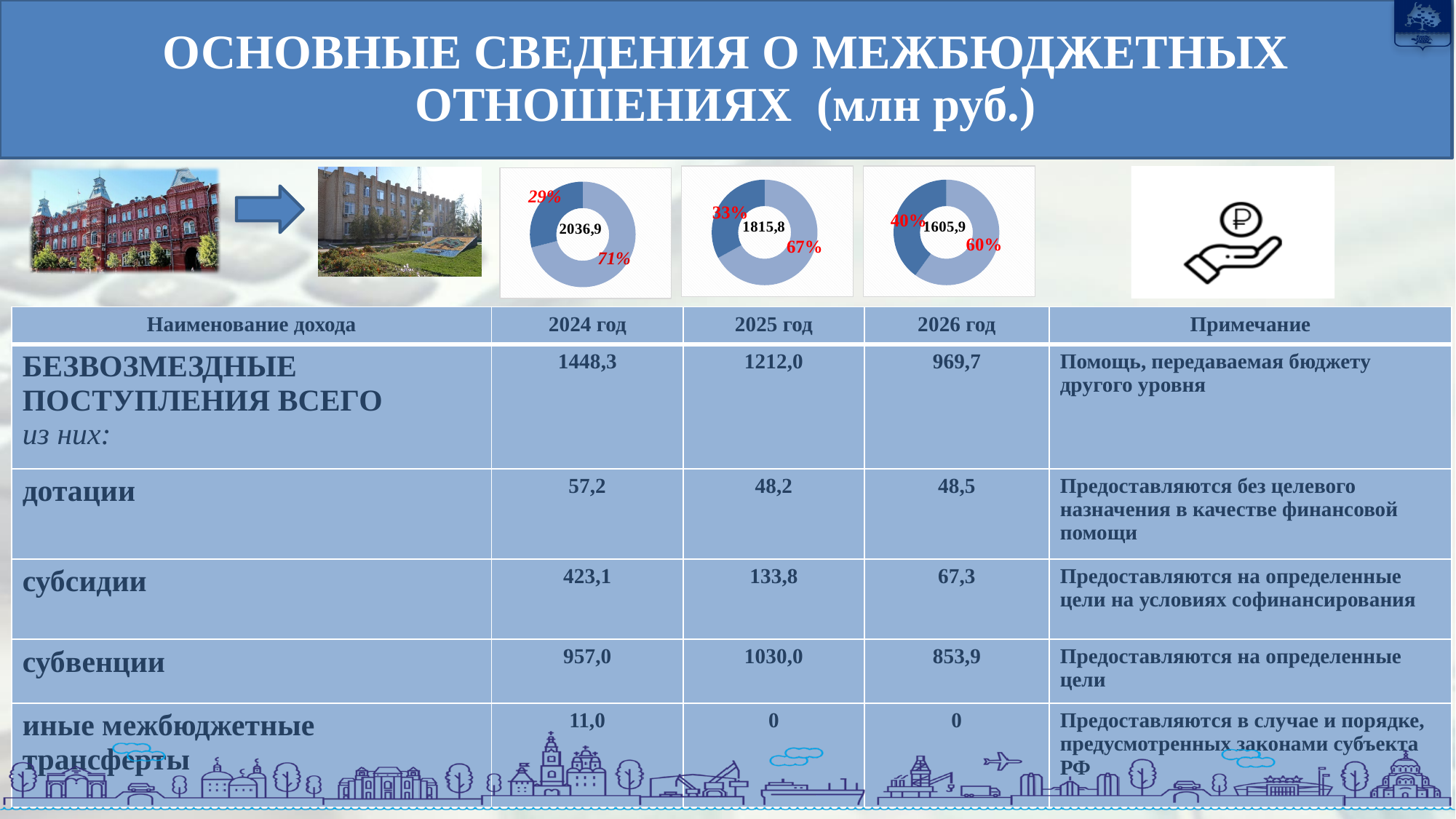
In the leftmost doughnut chart, what share is shown for the larger (light blue) slice? 71% What value is printed in the centre of the rightmost doughnut chart? 1605,9 How many slices does each doughnut chart on the slide have? 2 What is the difference between the light blue share in the leftmost doughnut chart and the light blue share in the rightmost doughnut chart? 11% What kind of chart is the leftmost chart on the slide? doughnut chart What value is printed in the centre of the middle doughnut chart? 1815,8 Is the centre value of the leftmost doughnut chart larger or smaller than the centre value of the rightmost doughnut chart? larger In the middle doughnut chart, what share is shown for the dark blue slice? 33% In the leftmost doughnut chart, what share is shown for the smaller (dark blue) slice? 29% Which of the three doughnut charts has the largest dark blue share? the rightmost chart (40%) What value is printed in the centre of the leftmost doughnut chart? 2036,9